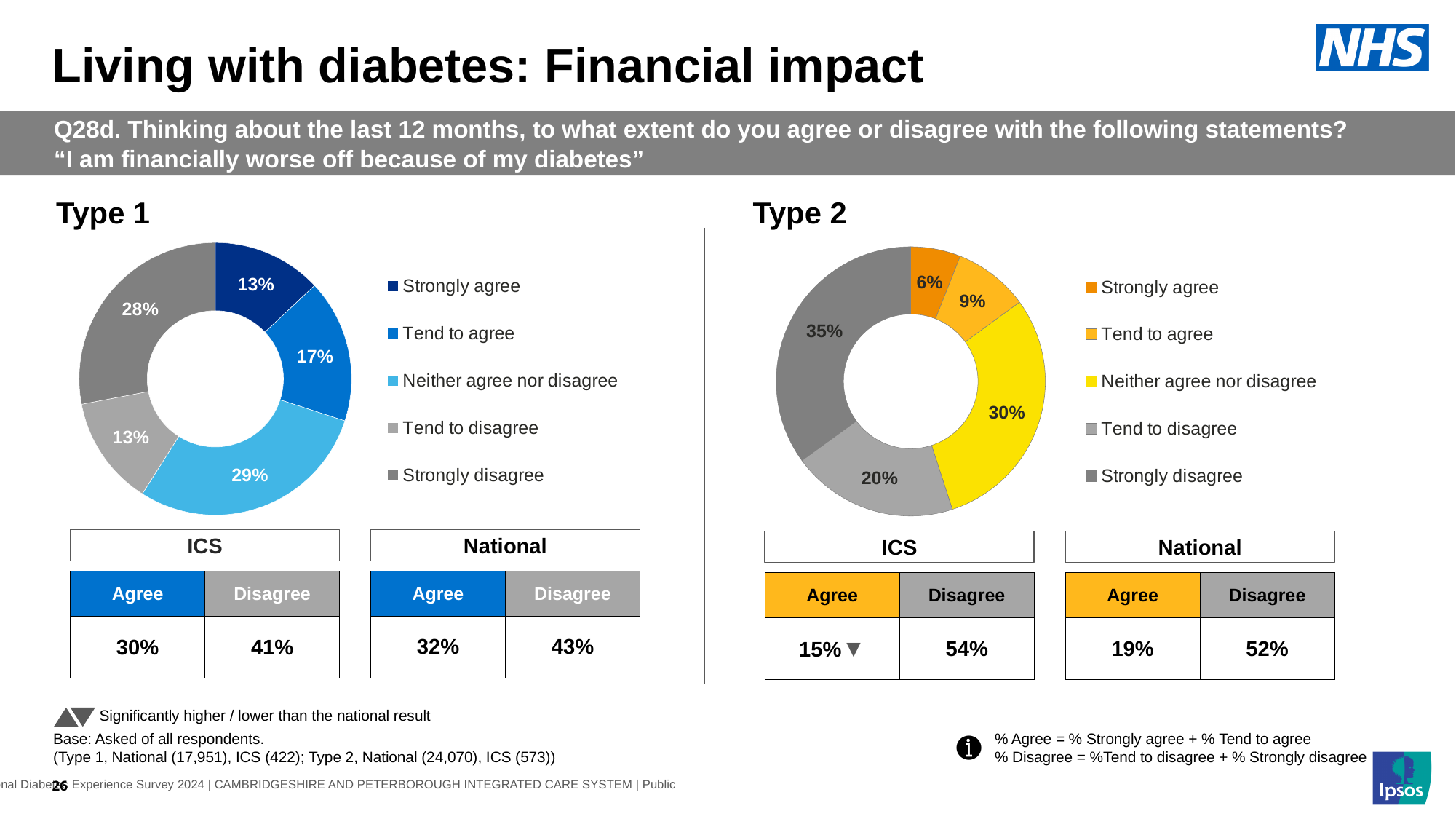
In the Type 1 chart, which response category has the largest share? Neither agree nor disagree In the Type 2 chart, what percentage of respondents said 'Strongly disagree'? 35% In the Type 2 chart, what is the difference between the 'Neither agree nor disagree' share and the 'Tend to disagree' share? 10% How many response categories does the legend of the Type 1 chart list? 5 In the Type 1 chart, what percentage of respondents said 'Neither agree nor disagree'? 29% What type of chart is used to show the Type 2 results? Donut (pie) chart In the Type 2 chart, which is larger: the 'Tend to agree' share or the 'Tend to disagree' share? Tend to disagree In the Type 1 chart, what percentage of respondents said 'Tend to agree'? 17% In the Type 1 chart, what is the difference between the 'Strongly disagree' share and the 'Tend to disagree' share? 15% In the Type 2 chart, which response category has the largest share? Strongly disagree In the Type 2 chart, which response category has the smallest share? Strongly agree In the Type 2 chart, what percentage of respondents said 'Strongly agree'? 6%